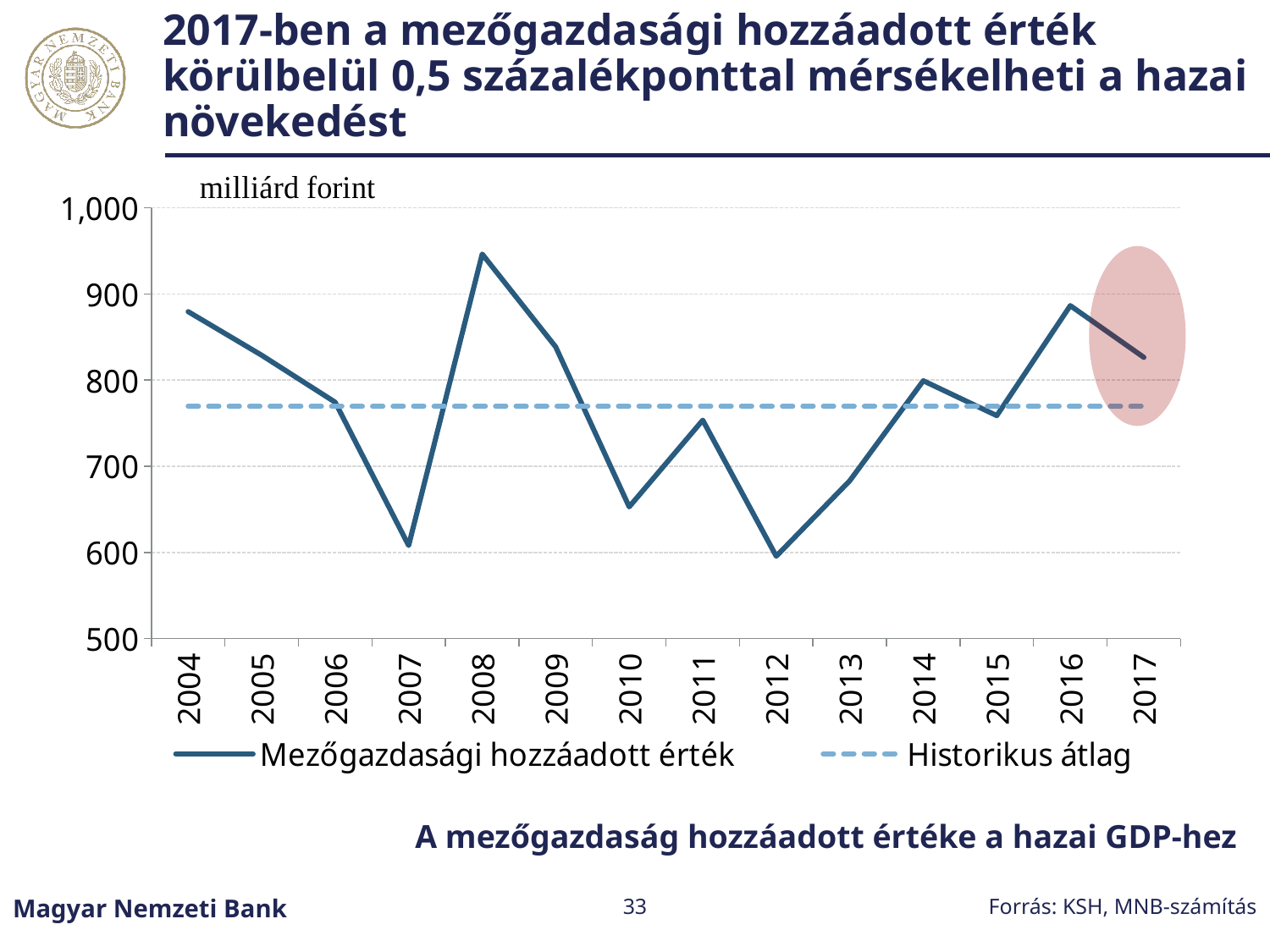
How many years are shown on the x axis? 14 Is the Mezőgazdasági hozzáadott érték for 2017 greater or less than 800? greater Is the Mezőgazdasági hozzáadott érték for 2008 greater or less than 900? greater Is the Mezőgazdasági hozzáadott érték for 2004 greater or less than 800? greater Does the Mezőgazdasági hozzáadott érték rise or fall from 2012 to 2016? rise What is the label of the dashed series in the legend? Historikus átlag Which is larger, the Mezőgazdasági hozzáadott érték in 2008 or in 2016? 2008 What kind of chart is shown on the slide? line chart How many series does the legend list? 2 In which year is the Mezőgazdasági hozzáadott érték highest? 2008 What unit is shown above the y axis? milliárd forint